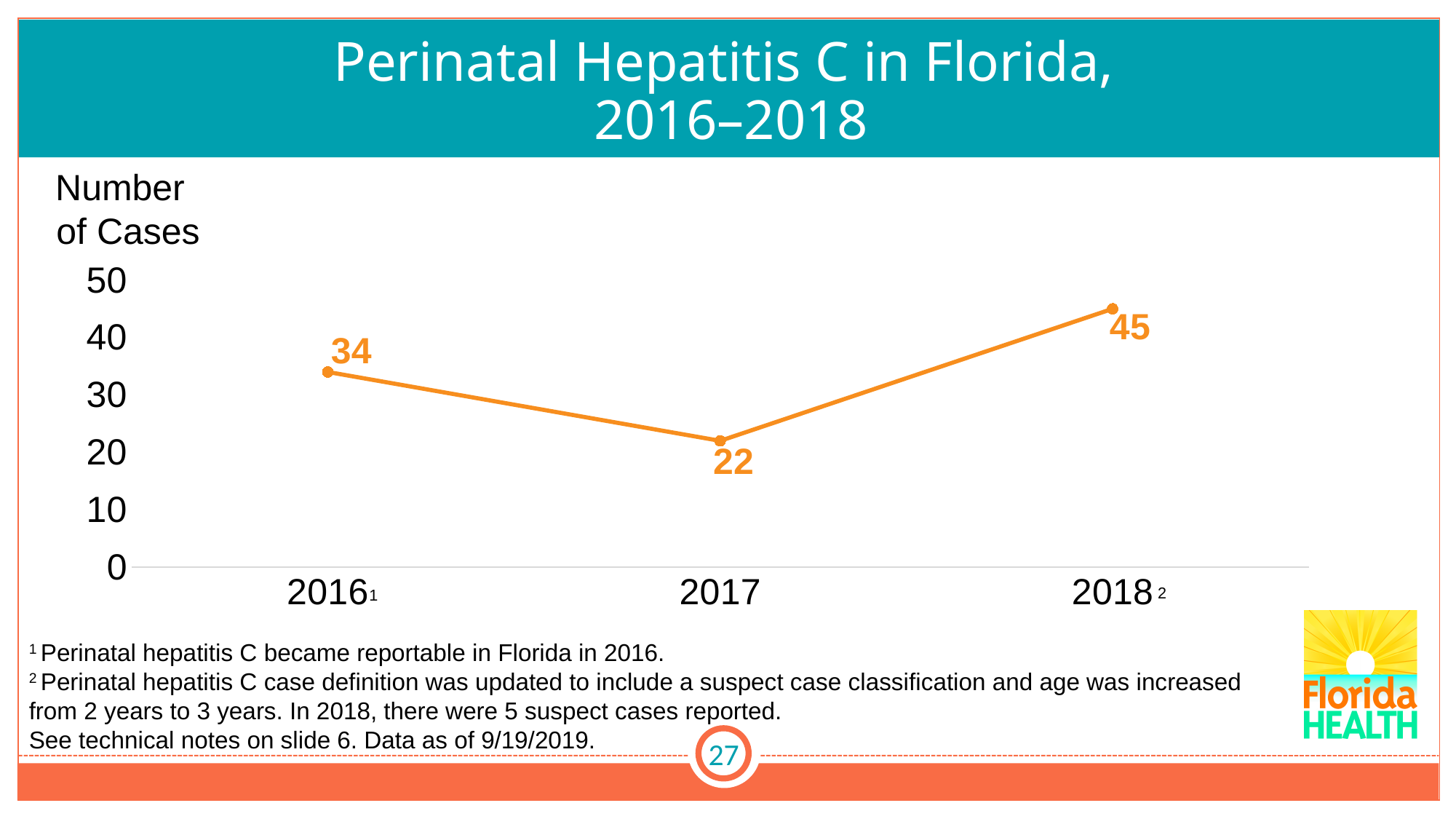
What kind of chart is shown on the slide? line chart How many years are plotted on the chart? 3 How many perinatal hepatitis C cases were reported in Florida in 2017? 22 What is the difference in the number of cases between 2016 and 2017? 12 What is the title of the chart? Perinatal Hepatitis C in Florida, 2016–2018 Which year had the highest number of perinatal hepatitis C cases? 2018 Is the number of cases in 2017 greater or less than 30? less How many perinatal hepatitis C cases were reported in Florida in 2016? 34 Which year had the lowest number of perinatal hepatitis C cases? 2017 What is the difference in the number of cases between 2018 and 2017? 23 How many perinatal hepatitis C cases were reported in Florida in 2018? 45 Which year had more cases, 2016 or 2018? 2018